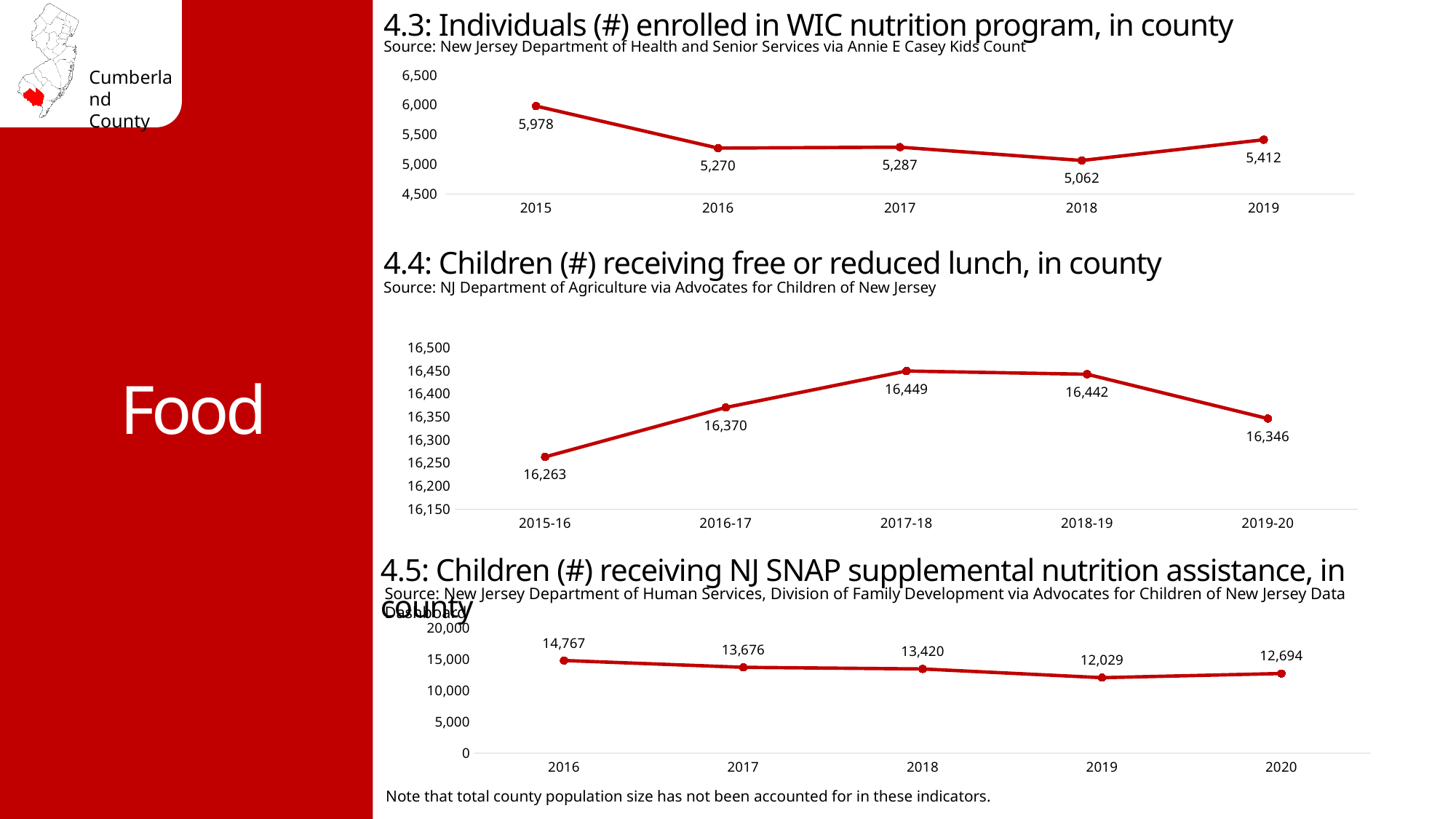
In the chart '4.5: Children (#) receiving NJ SNAP supplemental nutrition assistance, in county', what is the difference between the 2016 and 2017 values? 1,091 In the chart '4.4: Children (#) receiving free or reduced lunch, in county', what kind of chart is shown? line chart In the chart '4.4: Children (#) receiving free or reduced lunch, in county', is the value for 2015-16 larger or smaller than the value for 2019-20? smaller In the chart '4.3: Individuals (#) enrolled in WIC nutrition program, in county', how many years are plotted? 5 In the chart '4.4: Children (#) receiving free or reduced lunch, in county', which school year has the highest value? 2017-18 In the chart '4.5: Children (#) receiving NJ SNAP supplemental nutrition assistance, in county', what is the value for 2019? 12,029 In the chart '4.4: Children (#) receiving free or reduced lunch, in county', what is the value for 2016-17? 16,370 In the chart '4.3: Individuals (#) enrolled in WIC nutrition program, in county', which year has the lowest value? 2018 In the chart '4.3: Individuals (#) enrolled in WIC nutrition program, in county', what is the value for 2015? 5,978 In the chart '4.5: Children (#) receiving NJ SNAP supplemental nutrition assistance, in county', do the values generally rise or fall from 2016 to 2019? fall In the chart '4.3: Individuals (#) enrolled in WIC nutrition program, in county', what is the difference between the 2015 and 2019 values? 566 In the chart '4.5: Children (#) receiving NJ SNAP supplemental nutrition assistance, in county', which year has the highest value? 2016